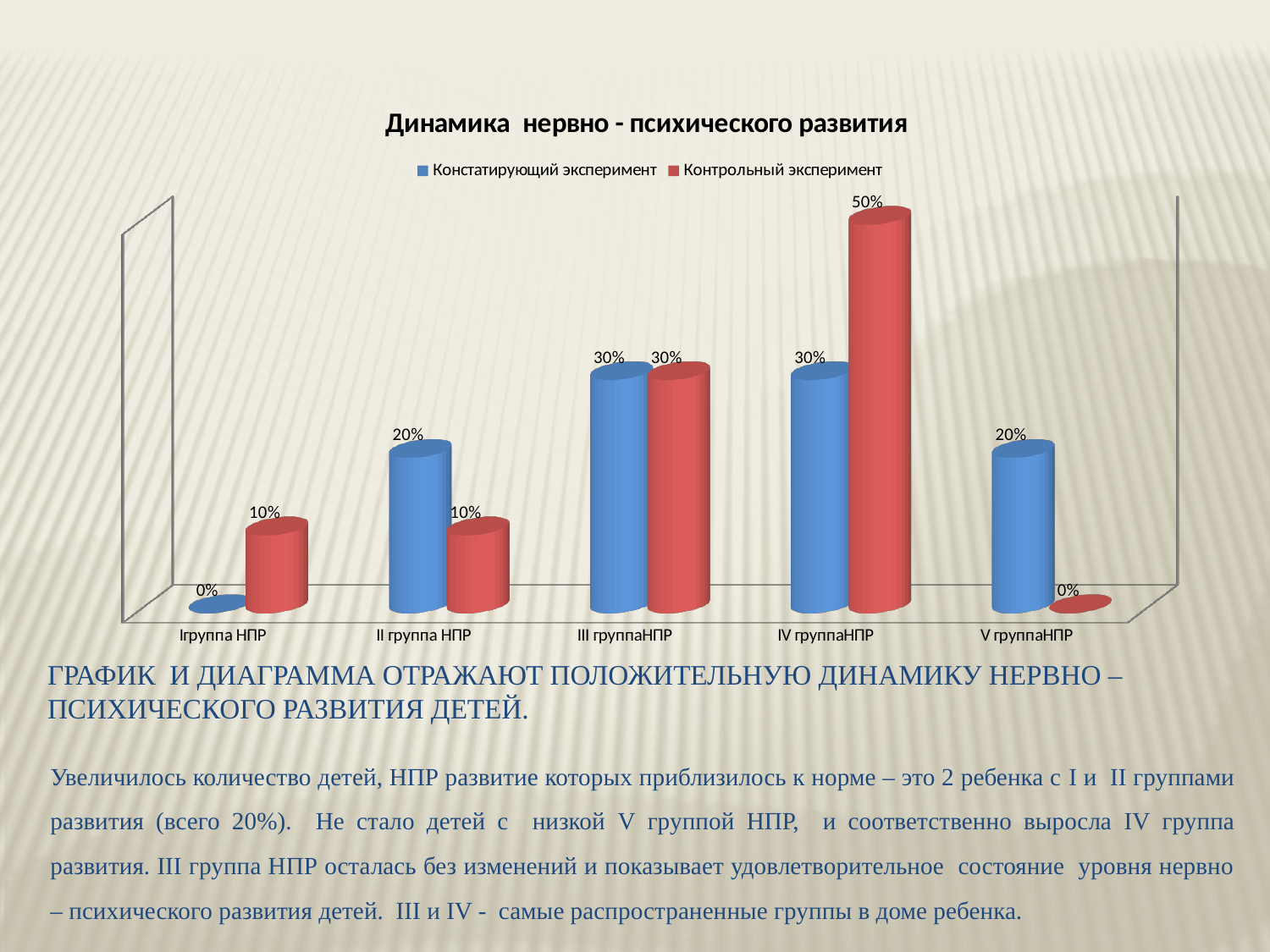
In II группа НПР, which series has the larger value, Констатирующий эксперимент or Контрольный эксперимент? Констатирующий эксперимент Which category has the highest value for Контрольный эксперимент? IV группаНПР How many series does the legend list? 2 What is the value for Контрольный эксперимент in V группаНПР? 0% How many categories are shown on the x axis? 5 What kind of chart is shown on the slide? Bar chart Which category has the lowest value for Констатирующий эксперимент? Iгруппа НПР What is the title of the chart? Динамика нервно - психического развития What is the value for Констатирующий эксперимент in Iгруппа НПР? 0% What is the difference between Контрольный эксперимент and Констатирующий эксперимент in IV группаНПР? 20% What is the value for Констатирующий эксперимент in II группа НПР? 20% What is the value for Контрольный эксперимент in IV группаНПР? 50%